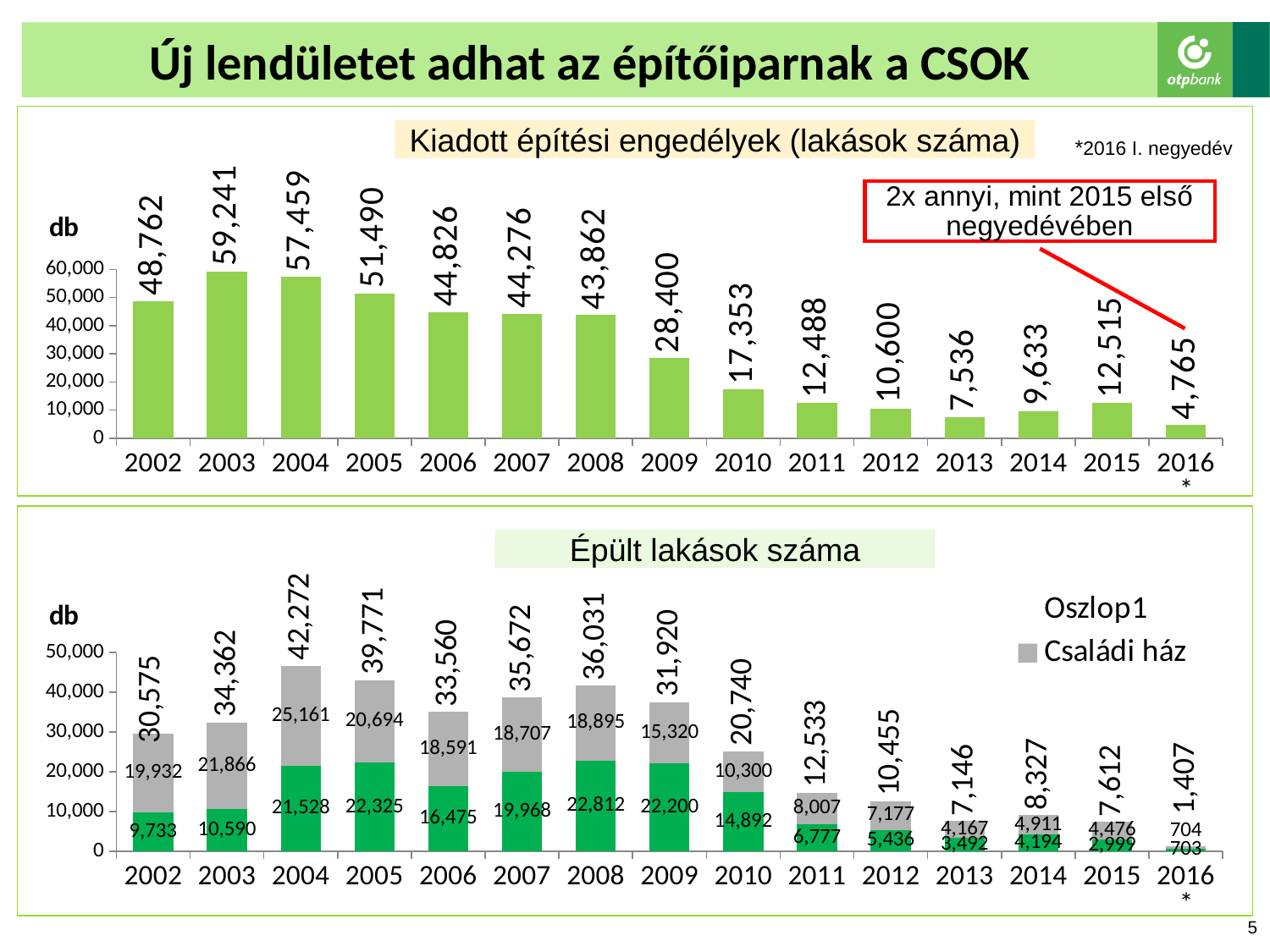
In the bottom chart (Épült lakások száma), what is the Családi ház value for 2008? 18,895 In the top chart (Kiadott építési engedélyek), which year has the larger value, 2010 or 2011? 2010 In the top chart (Kiadott építési engedélyek), which year has the highest value? 2003 In the top chart (Kiadott építési engedélyek), what is the difference between the values for 2003 and 2002? 10,479 In the bottom chart (Épült lakások száma), what is the difference between the totals for 2008 and 2009? 4,111 In the top chart (Kiadott építési engedélyek), do the values rise or fall from 2003 to 2013? fall In the top chart (Kiadott építési engedélyek), which year has the lowest value? 2016* What kind of chart is the bottom chart (Épült lakások száma)? stacked bar chart In the bottom chart (Épült lakások száma), which legend entry is shown with a gray marker? Családi ház In the top chart (Kiadott építési engedélyek), how many years are shown on the x axis? 15 In the bottom chart (Épült lakások száma), what is the total for 2004? 42,272 In the top chart (Kiadott építési engedélyek), what is the value for 2003? 59,241